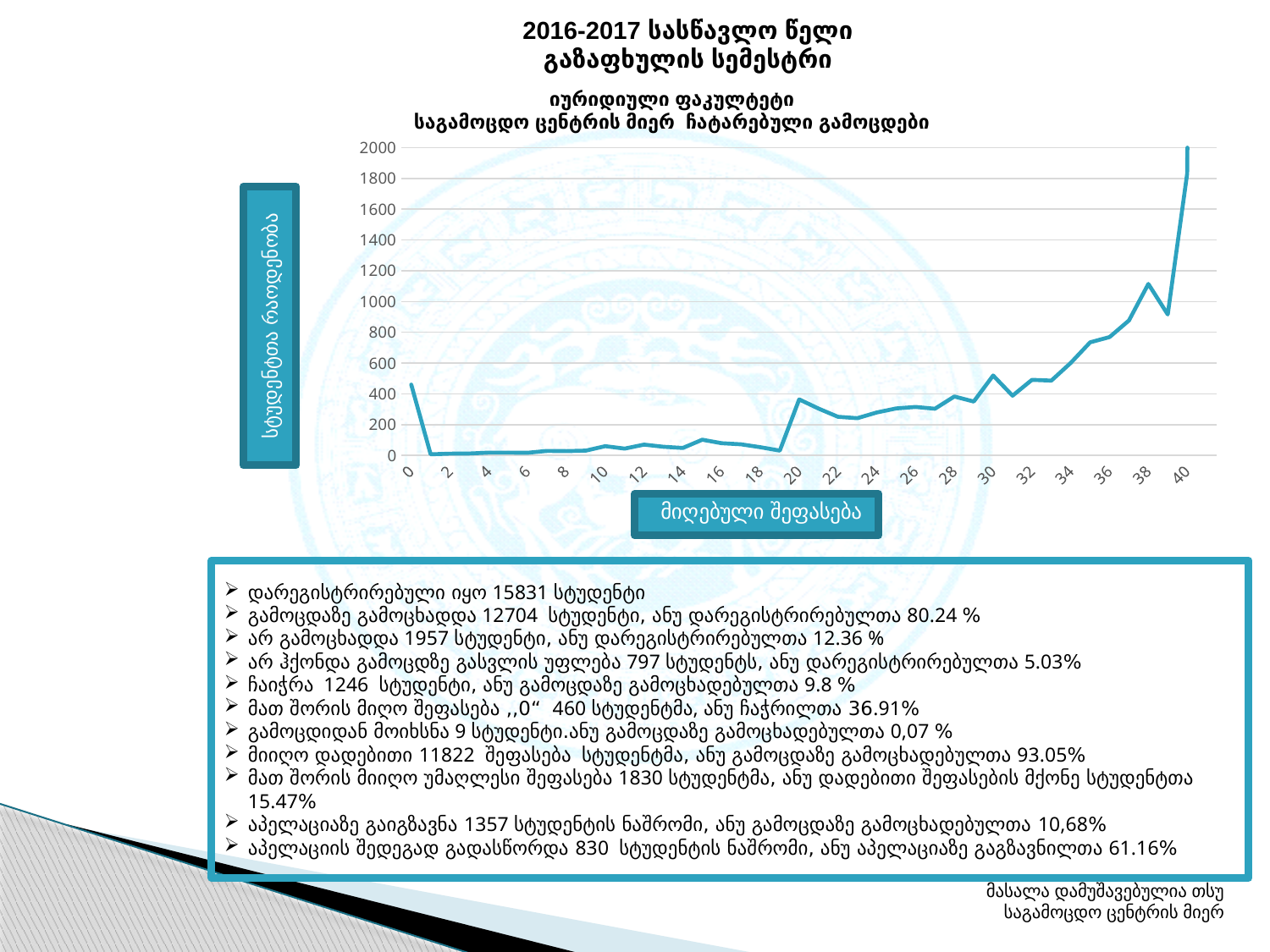
What kind of chart is shown on the slide? line chart Is the value at score 10 greater or less than 200? less Which is higher, the value at score 38 or the value at score 39? score 38 Is the value at score 40 greater or less than 1800? greater At which score on the x axis does the line reach its highest value? 40 Is the value at score 20 greater or less than 200? greater What is the label of the x axis? მიღებული შეფასება Does the line generally rise or fall between scores 20 and 40? rise Which is higher, the value at score 0 or the value at score 10? score 0 What is the highest value shown on the y axis? 2000